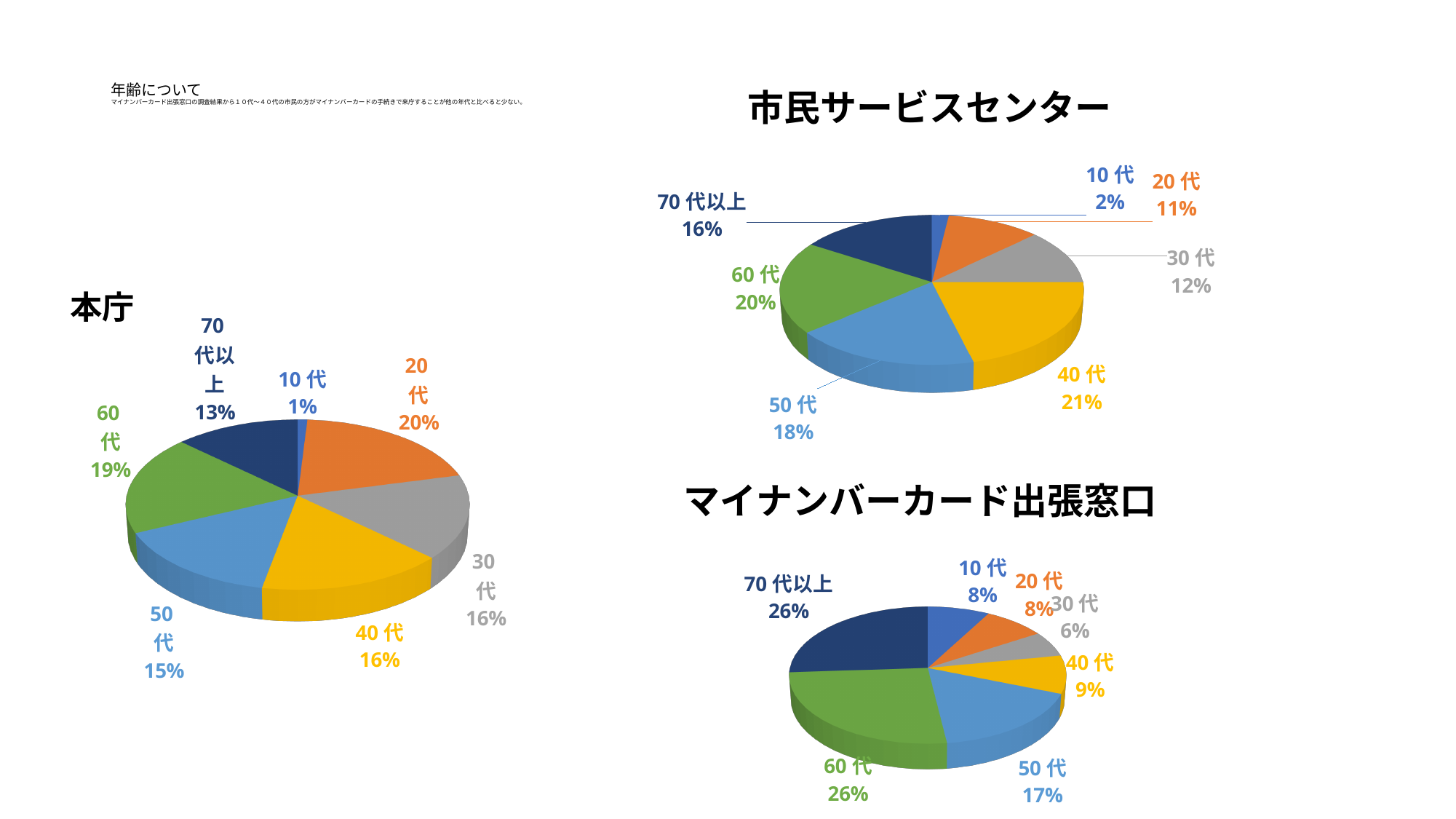
In the マイナンバーカード出張窓口 chart, which age group has the smallest share? 30 代 In the 市民サービスセンター chart, which age group has the largest share? 40 代 In the 本庁 chart, which age group has the largest share? 20 代 In the 本庁 chart, which age group has the smallest share? 10 代 In the 市民サービスセンター chart, what is the difference between the shares for 60 代 and 10 代? 18% In the 市民サービスセンター chart, which is larger, the share for 50 代 or the share for 30 代? 50 代 In the 市民サービスセンター chart, what share is shown for 40 代? 21% What type of chart is the マイナンバーカード出張窓口 chart? Pie chart How many pie charts are on the slide? 3 In the 本庁 chart, how many age groups are shown? 7 In the マイナンバーカード出張窓口 chart, what share is shown for 50 代? 17% In the 本庁 chart, what share is shown for 20 代? 20%